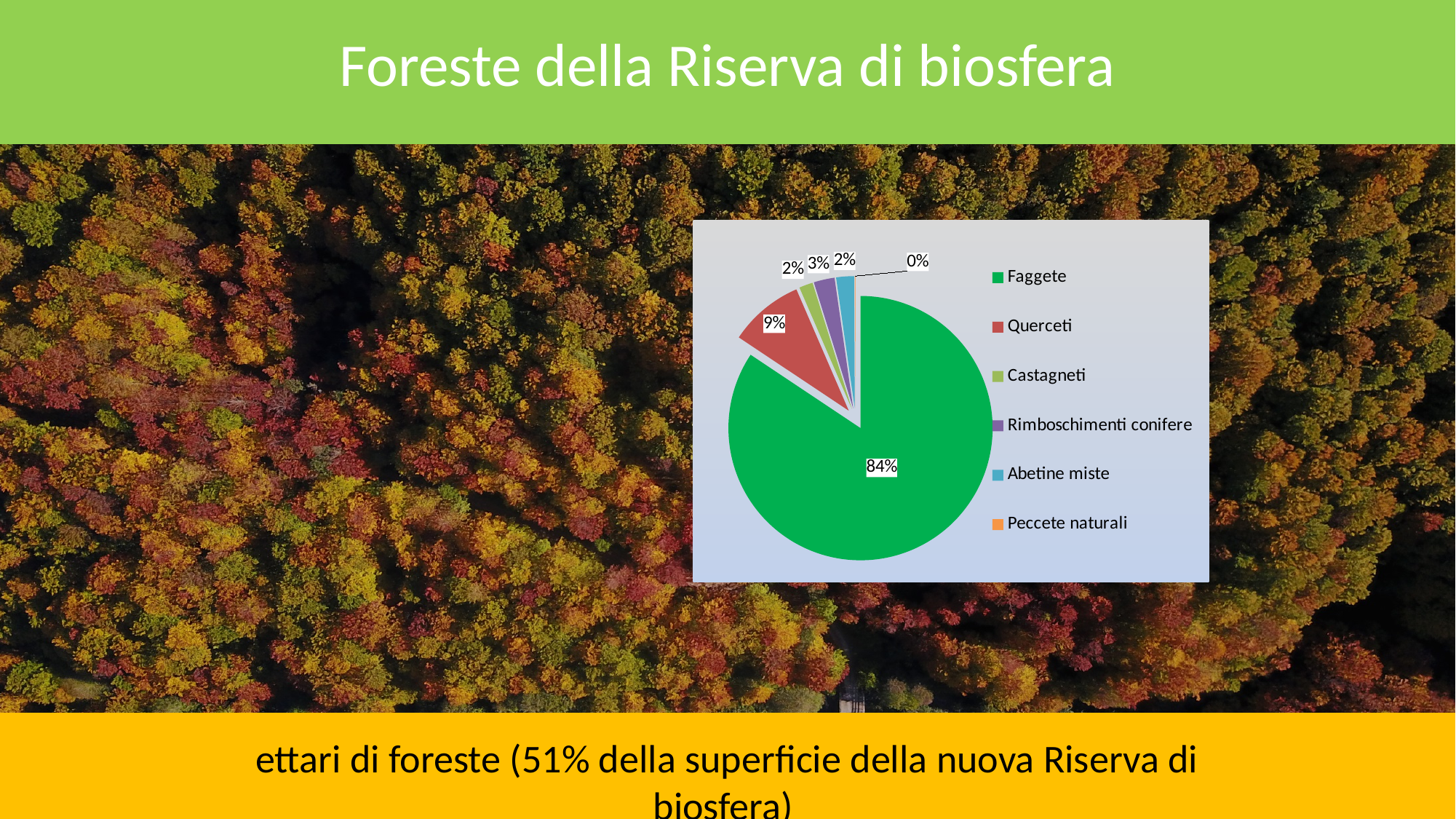
Which is larger, the share for Querceti or the share for Rimboschimenti conifere? Querceti What share of the pie does Abetine miste represent? 2% What is the difference in percentage points between Faggete and Querceti? 75 Which category has the largest slice of the pie? Faggete What share of the pie does Faggete represent? 84% What share of the pie does Querceti represent? 9% What kind of chart is shown on the slide? pie chart Which category has the smallest slice of the pie? Peccete naturali How many categories does the legend list? 6